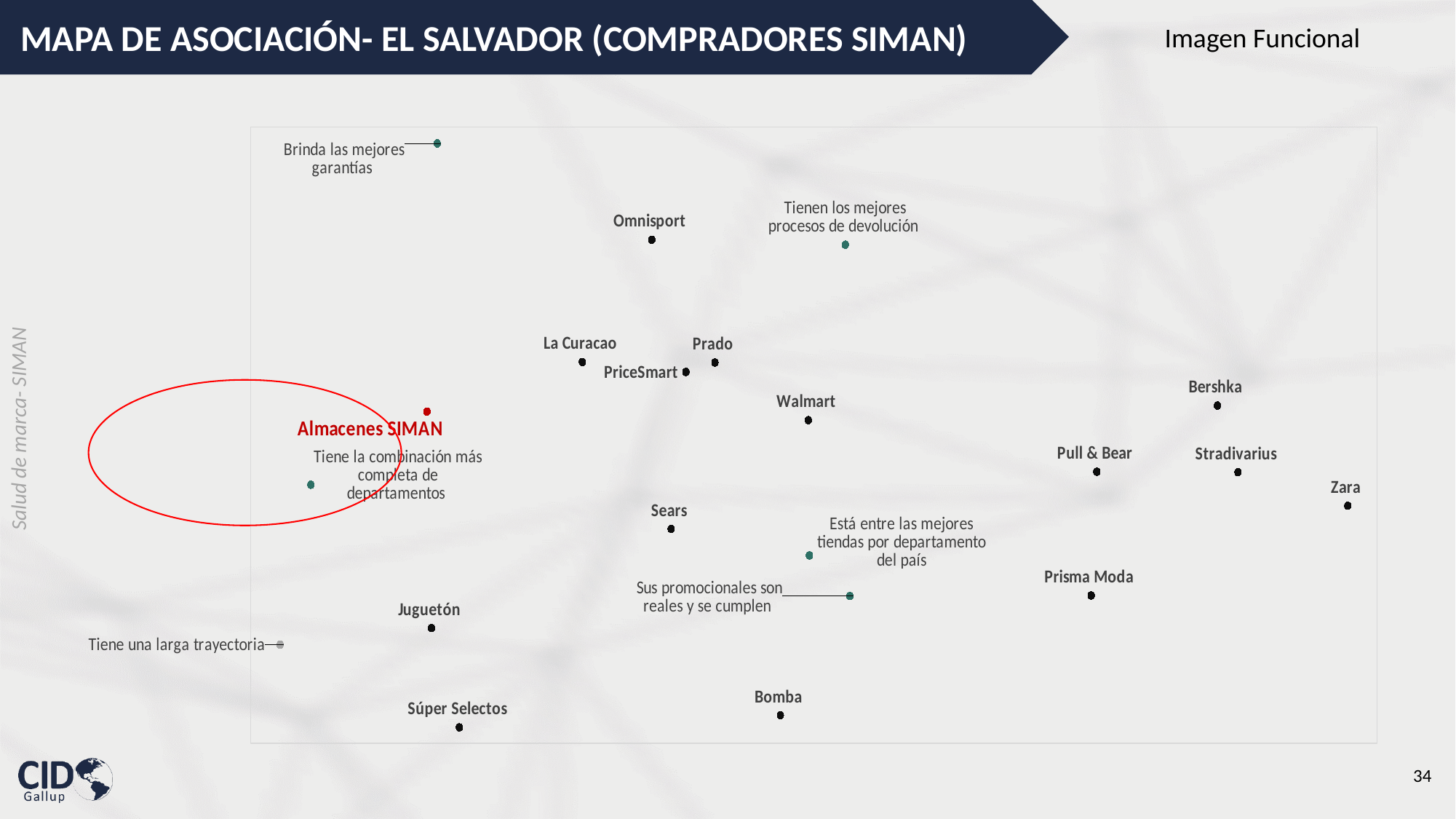
What kind of chart is shown on the slide? Scatter plot (association map) Which brand is highlighted in red on the map? Almacenes SIMAN Which attribute is positioned at the very top of the map? Brinda las mejores garantías How many brands are plotted on the association map? 15 Which attribute is enclosed in the red circle together with Almacenes SIMAN? Tiene la combinación más completa de departamentos Which brand is closest to the attribute 'Tiene una larga trayectoria'? Juguetón Which attribute is closest to Omnisport on the map? Tienen los mejores procesos de devolución Which brand is positioned highest on the map? Omnisport Which brand is positioned farthest to the right on the map? Zara What is the title of the slide containing the map? MAPA DE ASOCIACIÓN- EL SALVADOR (COMPRADORES SIMAN) How many attribute statements (green/grey points) are plotted on the map? 6 Which brand is positioned lowest on the map? Súper Selectos